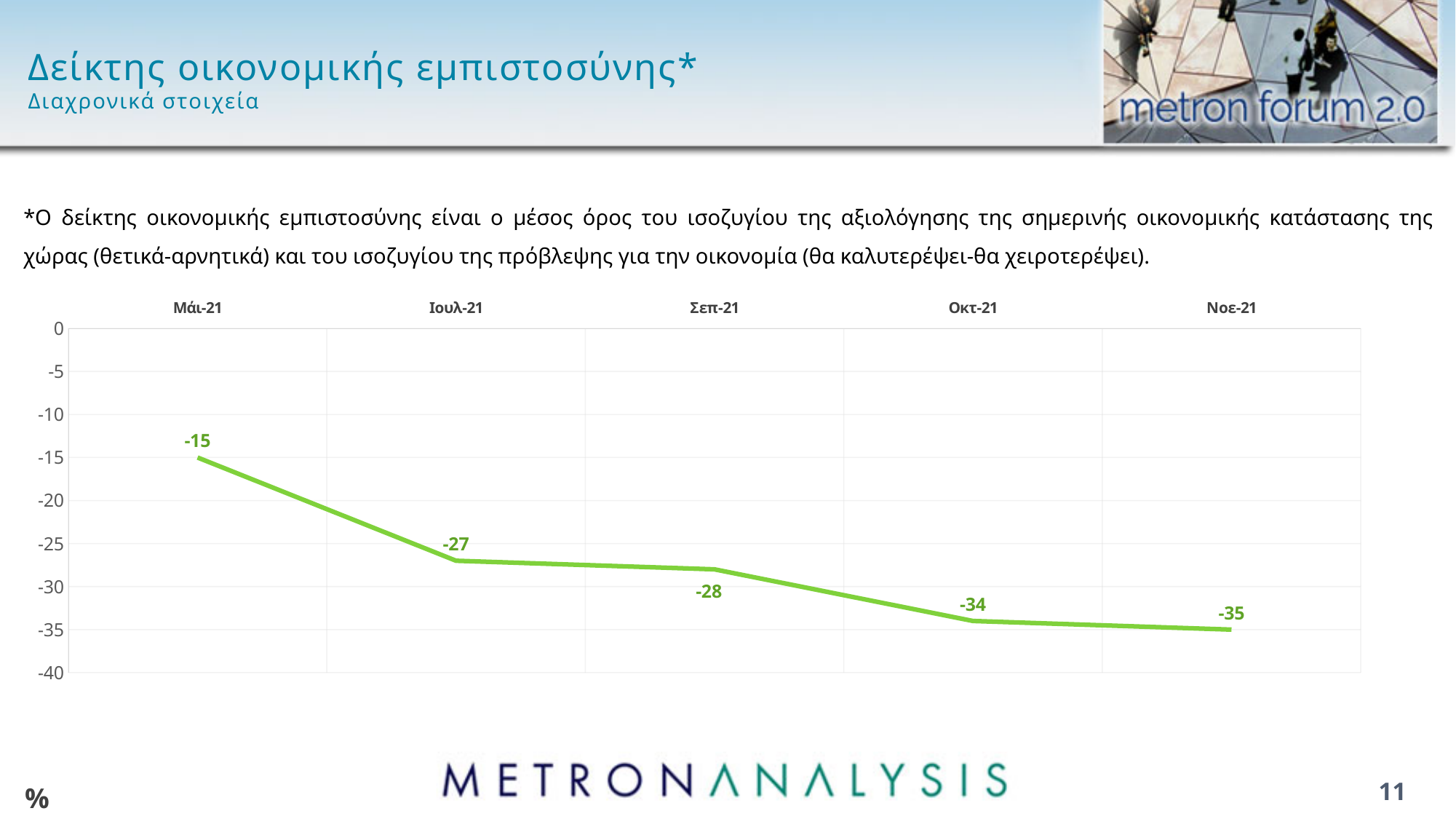
Which period has the highest value on the chart? Μάι-21 Do the values rise or fall from Μάι-21 to Νοε-21? fall What is the difference between the values for Μάι-21 and Νοε-21? 20 Which period has the lowest value on the chart? Νοε-21 Which is larger, the value for Ιουλ-21 or the value for Οκτ-21? Ιουλ-21 What is the value of the economic confidence index for Μάι-21? -15 How many time points are plotted on the chart? 5 What is the value of the economic confidence index for Νοε-21? -35 What is the value shown for Σεπ-21? -28 What colour is the line on the chart? green What is the difference between the values for Ιουλ-21 and Οκτ-21? 7 What kind of chart is shown on the slide? line chart